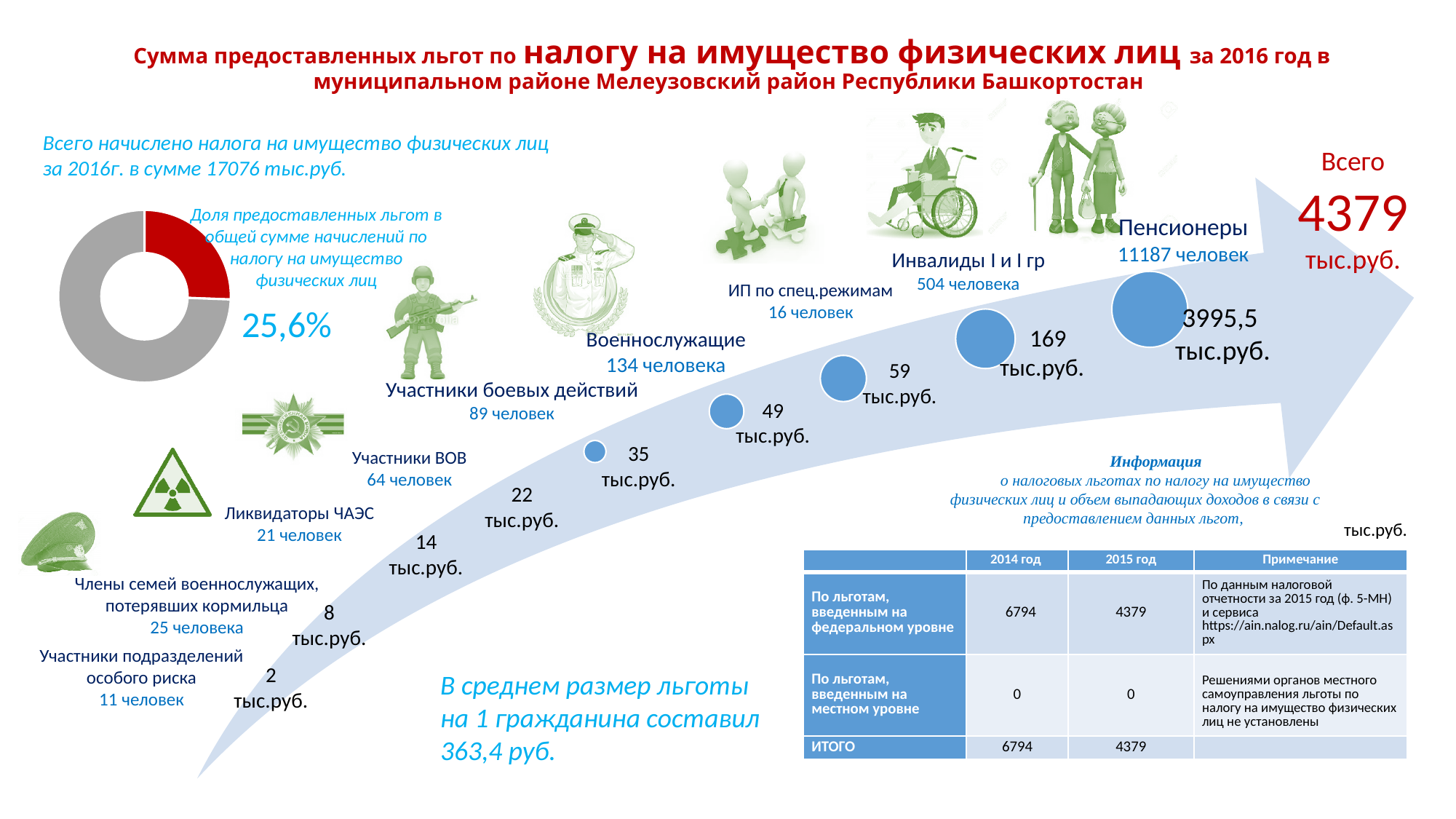
In the arrow infographic, what is the total amount of benefits granted (Всего)? 4379 тыс.руб. In the arrow infographic, what is the amount of benefits for Пенсионеры? 3995,5 тыс.руб. In the donut chart on the left, which slice is larger: the red slice or the grey slice? the grey slice According to the text above the donut chart, what was the total assessed property tax on individuals for 2016? 17076 тыс.руб. In the arrow infographic, which category has the largest amount of benefits? Пенсионеры How many slices does the donut chart on the left have? 2 In the arrow infographic, how many people are in the Пенсионеры category? 11187 человек How many blue bubbles (data points) are placed along the arrow in the infographic? 5 In the arrow infographic, how many people are in the Инвалиды I и II гр category? 504 человека What kind of chart is shown on the left of the slide, below the text about the total assessed tax? pie chart (donut) What colour is the slice representing the share of granted benefits (25,6%) in the donut chart? red In the donut chart on the left, what share of the total assessed property tax do the granted benefits represent? 25,6%